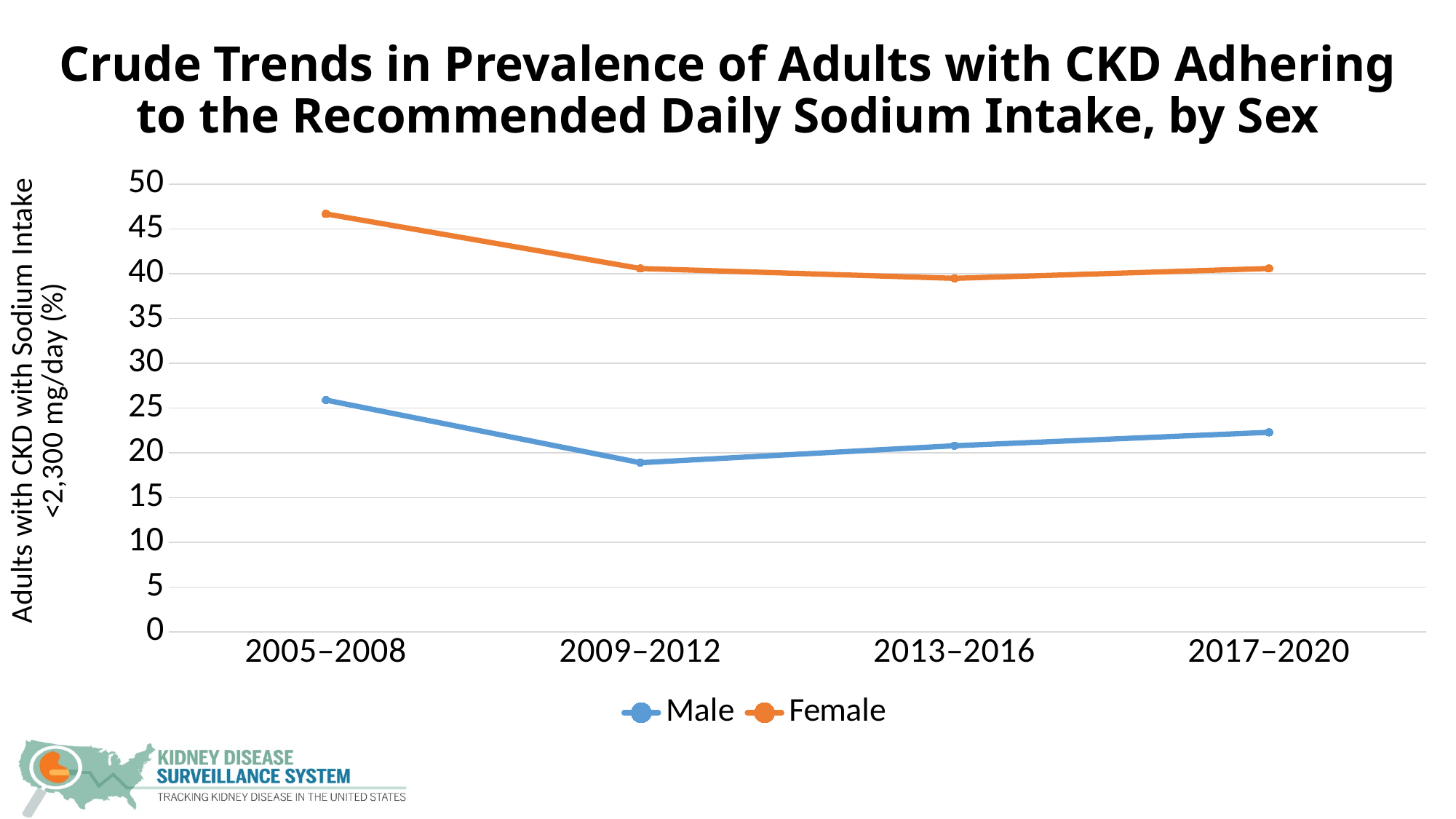
What colour is the Female line? orange Which series has the higher value in 2005–2008, Male or Female? Female What kind of chart is shown on the slide? line chart In which period is the Male value lowest? 2009–2012 Does the Male line rise or fall from 2009–2012 to 2017–2020? rise How many series does the legend list? 2 Is the Male value for 2005–2008 greater or less than 25? greater How many time periods are shown on the x axis? 4 Is the Male value for 2009–2012 greater or less than 20? less Is the Female value for 2005–2008 greater or less than 45? greater Does the Female line rise or fall from 2005–2008 to 2009–2012? fall In which period is the Female value highest? 2005–2008